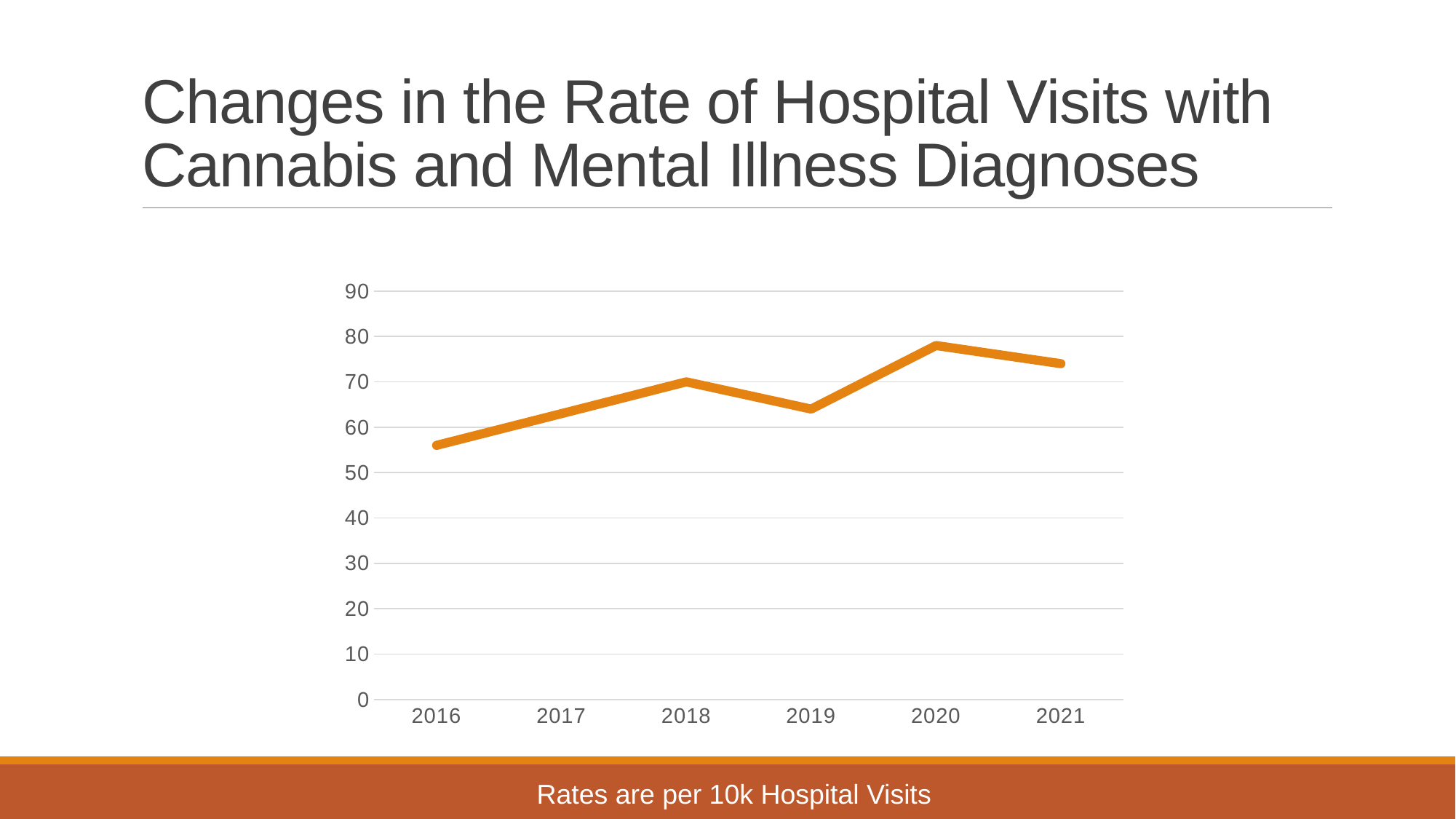
Is the value for 2021 greater or less than 70? greater According to the footer, what are the rates expressed per? Per 10k Hospital Visits Is the value for 2016 greater or less than 60? less Is the value for 2020 greater or less than 70? greater What kind of chart is shown on the slide? Line chart Does the rate rise or fall from 2020 to 2021? Falls How many years are plotted along the x axis? 6 Does the rate rise or fall from 2016 to 2018? Rises Which year has the highest rate of hospital visits with cannabis and mental illness diagnoses? 2020 Which year has the lowest rate of hospital visits with cannabis and mental illness diagnoses? 2016 Which year has the larger value, 2018 or 2019? 2018